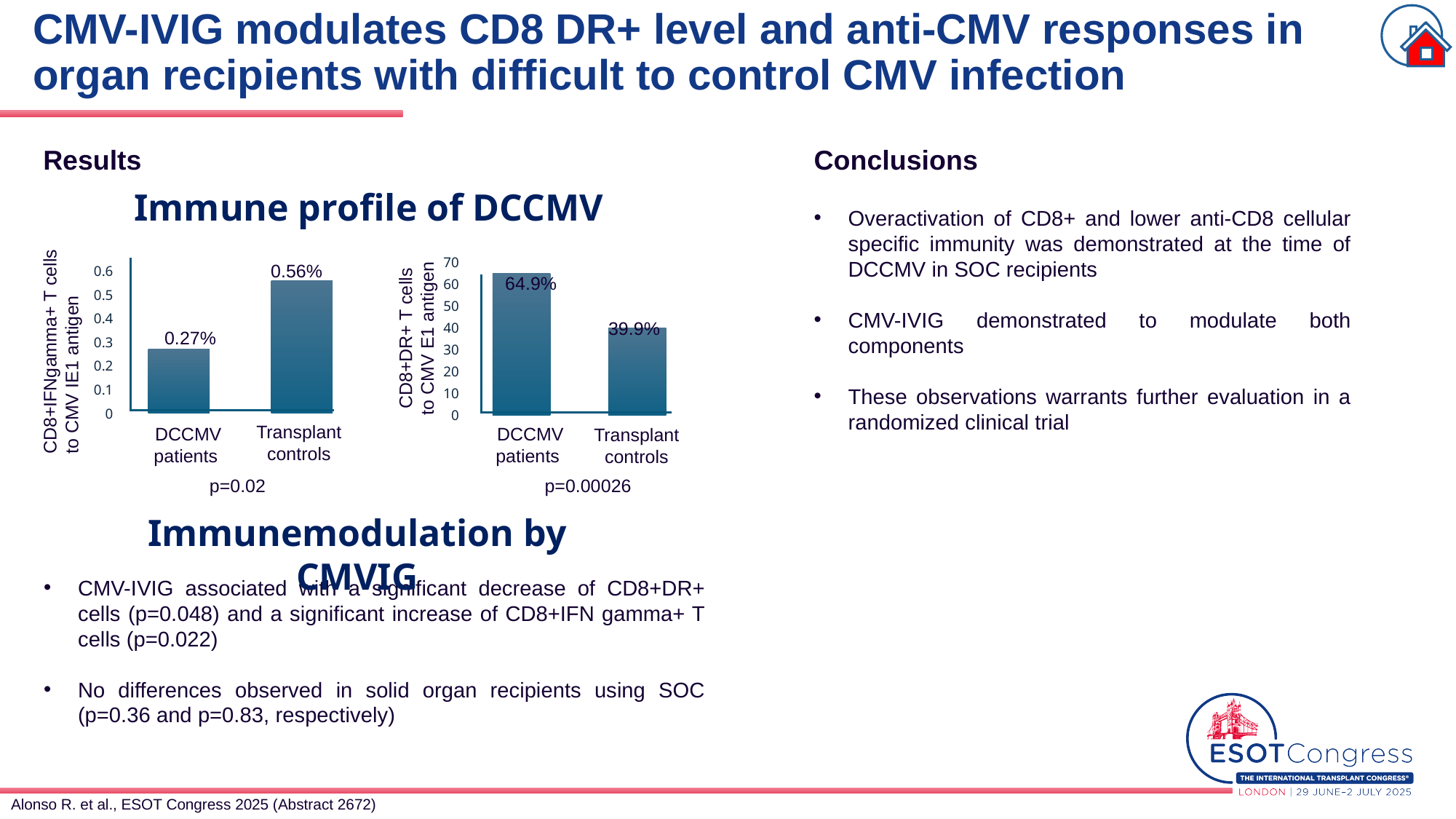
In the left chart (CD8+IFNgamma+ T cells to CMV IE1 antigen), what is the value for Transplant controls? 0.56% What p-value is shown below the right chart (CD8+DR+ T cells to CMV E1 antigen)? p=0.00026 In the right chart (CD8+DR+ T cells to CMV E1 antigen), what is the difference between DCCMV patients and Transplant controls? 25.0% What kind of chart is the right chart (CD8+DR+ T cells to CMV E1 antigen)? Bar chart In the right chart (CD8+DR+ T cells to CMV E1 antigen), is the value for DCCMV patients greater or less than 60? greater In the right chart (CD8+DR+ T cells to CMV E1 antigen), which group has the lower value? Transplant controls In the right chart (CD8+DR+ T cells to CMV E1 antigen), what is the value for Transplant controls? 39.9% In the left chart (CD8+IFNgamma+ T cells to CMV IE1 antigen), what is the value for DCCMV patients? 0.27% How many categories does the left chart (CD8+IFNgamma+ T cells to CMV IE1 antigen) show? 2 In the left chart (CD8+IFNgamma+ T cells to CMV IE1 antigen), what is the difference between Transplant controls and DCCMV patients? 0.29% In the right chart (CD8+DR+ T cells to CMV E1 antigen), what is the value for DCCMV patients? 64.9% In the left chart (CD8+IFNgamma+ T cells to CMV IE1 antigen), which group has the higher value? Transplant controls